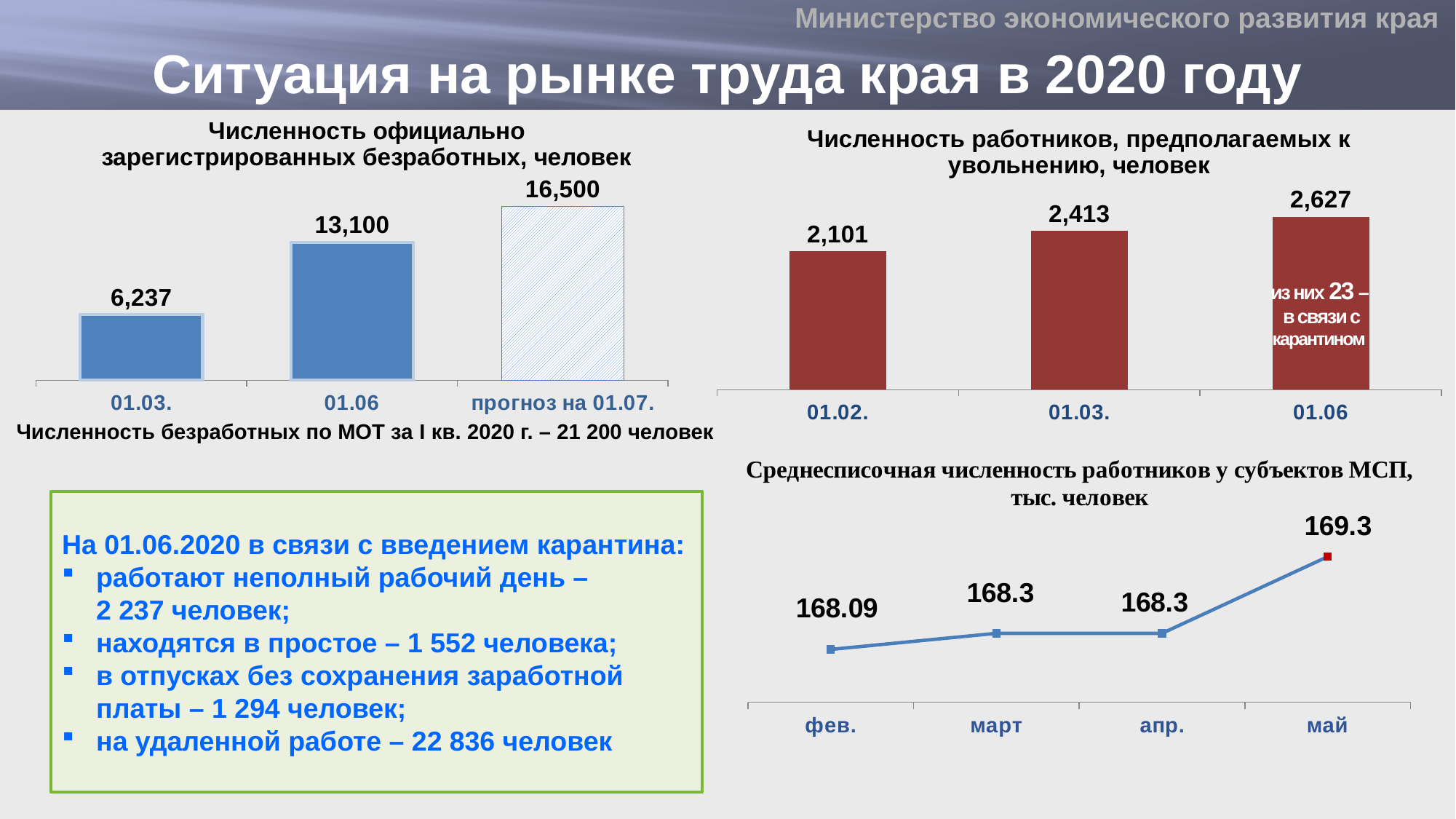
In the chart 'Среднесписочная численность работников у субъектов МСП, тыс. человек', which is larger: the value for фев. or the value for март? март In the chart 'Численность официально зарегистрированных безработных, человек', what is the difference between the values for 01.06 and 01.03.? 6,863 In the chart 'Численность официально зарегистрированных безработных, человек', which category has the lowest value? 01.03. What type of chart is 'Среднесписочная численность работников у субъектов МСП, тыс. человек'? line chart In the chart 'Численность официально зарегистрированных безработных, человек', what is the value for 01.06? 13,100 In the chart 'Численность работников, предполагаемых к увольнению, человек', what is the difference between the values for 01.06 and 01.03.? 214 In the chart 'Численность официально зарегистрированных безработных, человек', what is the forecast value for 01.07 (прогноз на 01.07.)? 16,500 In the chart 'Численность работников, предполагаемых к увольнению, человек', do the values rise or fall from 01.02. to 01.06? rise In the chart 'Среднесписочная численность работников у субъектов МСП, тыс. человек', what is the value for май? 169.3 In the chart 'Численность работников, предполагаемых к увольнению, человек', which category has the highest value? 01.06 In the chart 'Среднесписочная численность работников у субъектов МСП, тыс. человек', how many data points are plotted? 4 In the chart 'Численность работников, предполагаемых к увольнению, человек', what is the value for 01.02.? 2,101